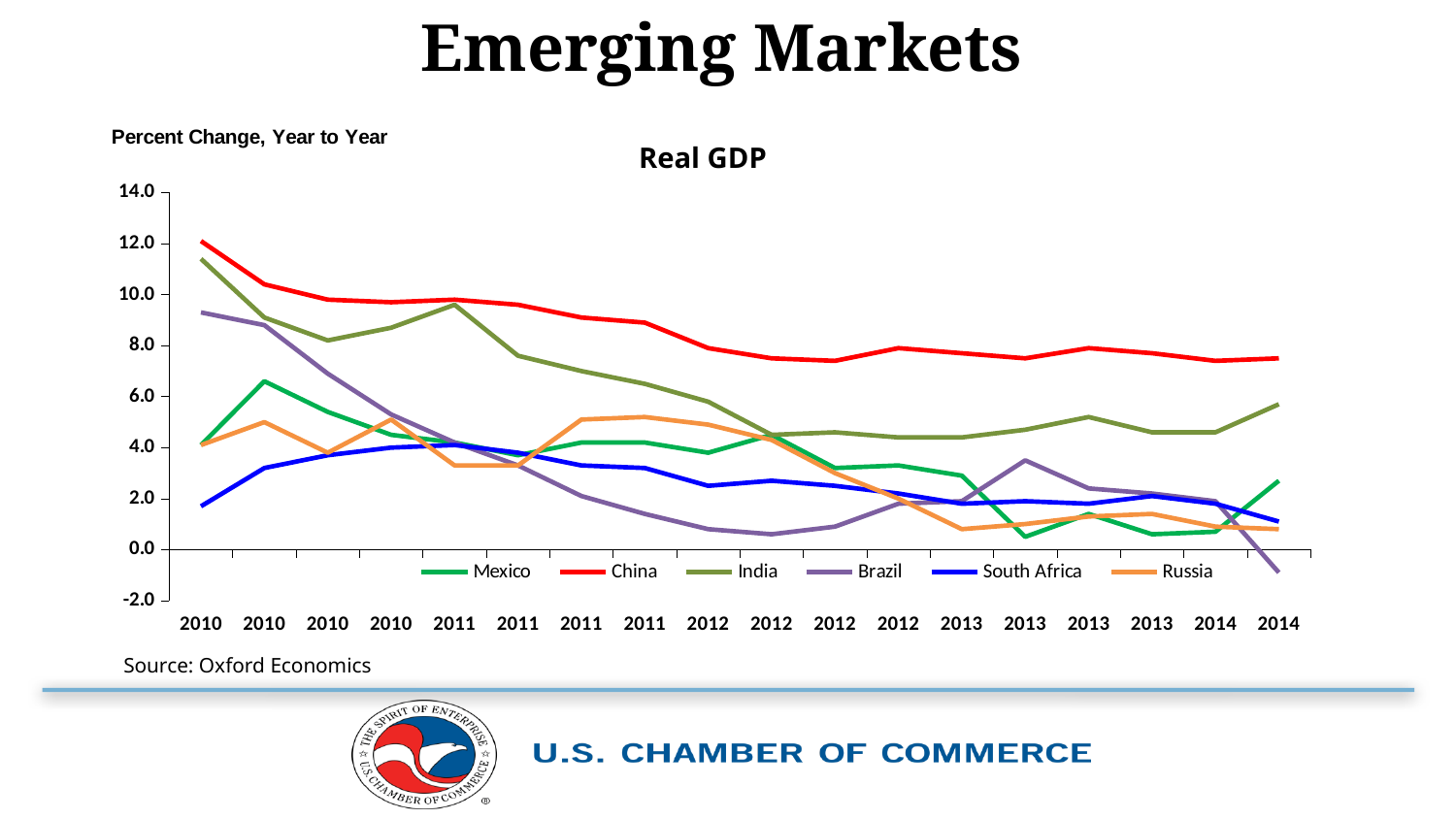
Which country has the highest value at the first 2010 point? China How many points are plotted along the x axis for each series? 18 Which country has the highest value at the last 2014 point? China Which country has the lowest value at the first 2010 point? South Africa What kind of chart is shown on the slide? Line chart Is the value for Brazil at the last 2014 point greater or less than 0.0? less How many series does the legend list? 6 What is the source cited below the chart? Oxford Economics Does the line for China generally rise or fall from 2010 to 2014? fall Is the value for China at the first 2010 point greater or less than 10.0? greater What is the title of the chart? Real GDP Is the value for Russia at the first 2013 point greater or less than 2.0? less